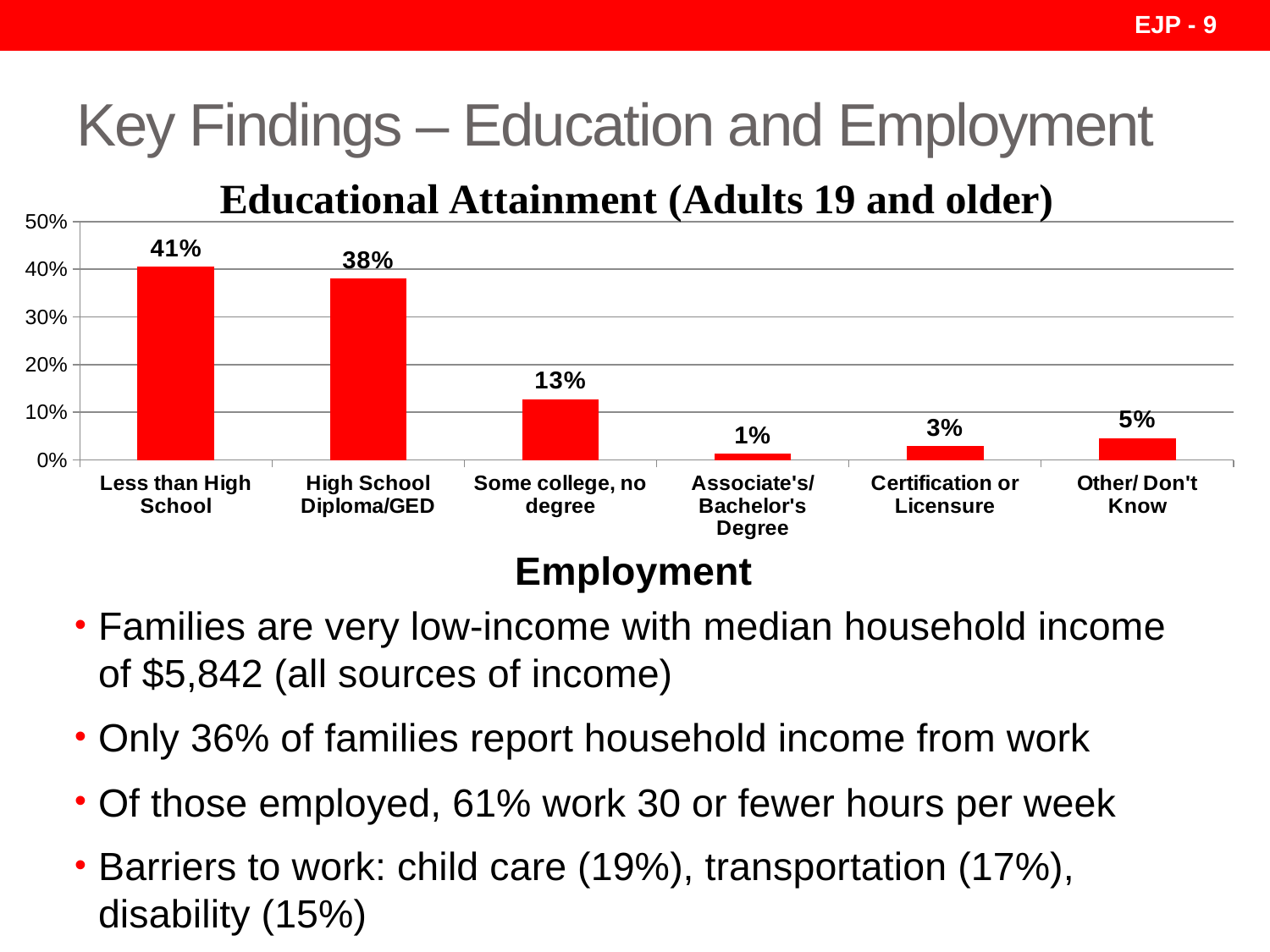
What percentage of adults have some college, no degree? 13% What is the value for High School Diploma/GED? 38% What is the title of the chart? Educational Attainment (Adults 19 and older) Which category has the highest value? Less than High School What type of chart is shown? bar chart Which category has the lowest value? Associate's/ Bachelor's Degree Which is larger, Other/ Don't Know or Certification or Licensure? Other/ Don't Know Is the value for Some college, no degree greater or less than 20%? less What is the value for Certification or Licensure? 3% What is the difference between Less than High School and High School Diploma/GED? 3% What percentage of adults 19 and older have less than a high school education? 41% How many categories are shown in the chart? 6